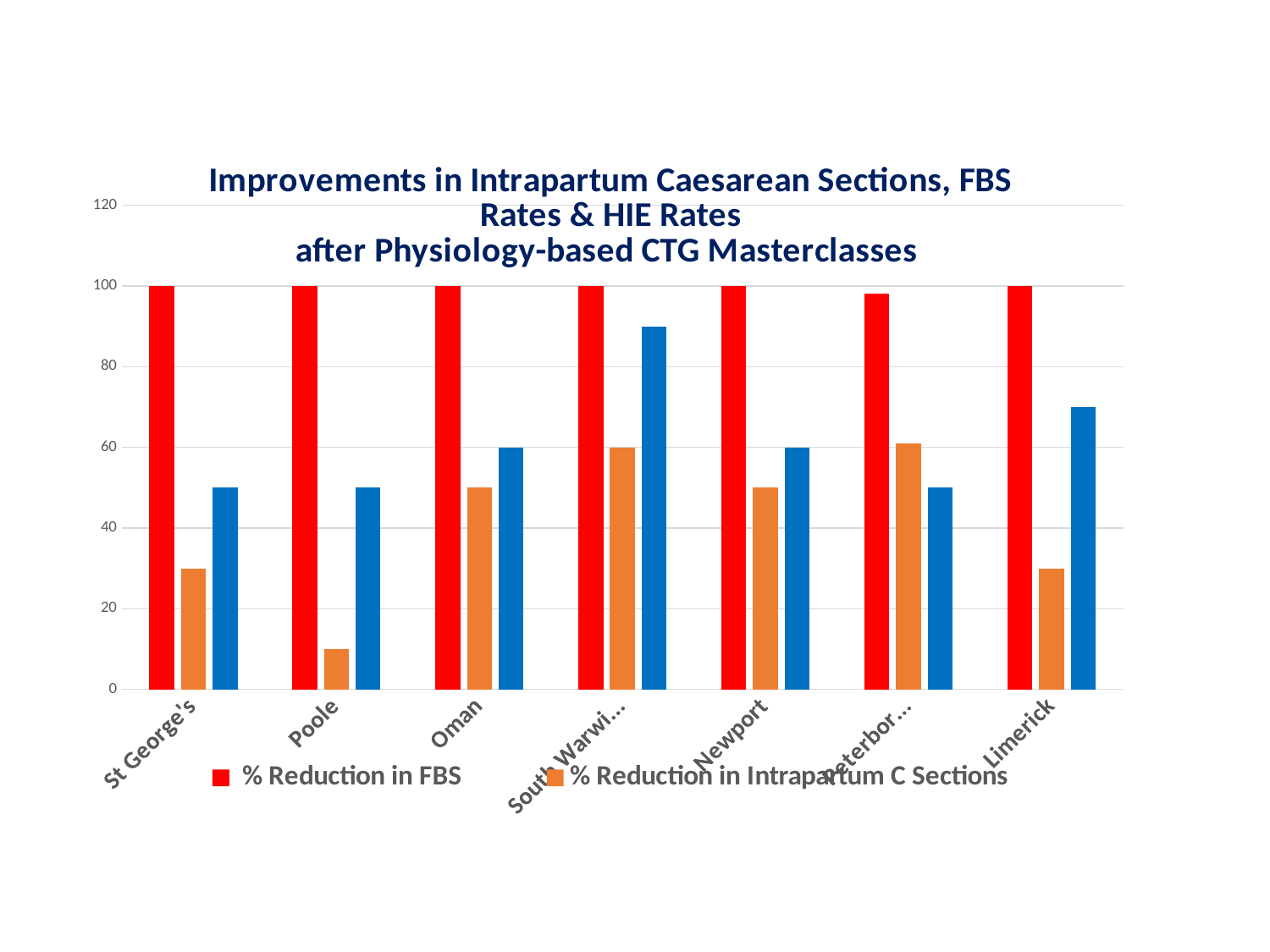
What is the difference between the % Reduction in FBS bar and the blue bar for Oman? 40 What is the value of the % Reduction in Intrapartum C Sections bar for the fourth category (South Warwi...)? 60 What kind of chart is shown on the slide? bar chart Which category has the highest blue bar? South Warwi... How many categories (hospitals/locations) are shown on the x axis? 7 Which category has the lowest % Reduction in Intrapartum C Sections bar? Poole What is the value of the % Reduction in FBS bar for St George's? 100 Which is larger: the % Reduction in Intrapartum C Sections bar for St George's or for Poole? St George's What is the value of the % Reduction in FBS bar for Limerick? 100 What colour represents % Reduction in FBS in the legend? red Is the % Reduction in Intrapartum C Sections bar for Poole greater or less than 20? less What is the value of the blue bar for Oman? 60